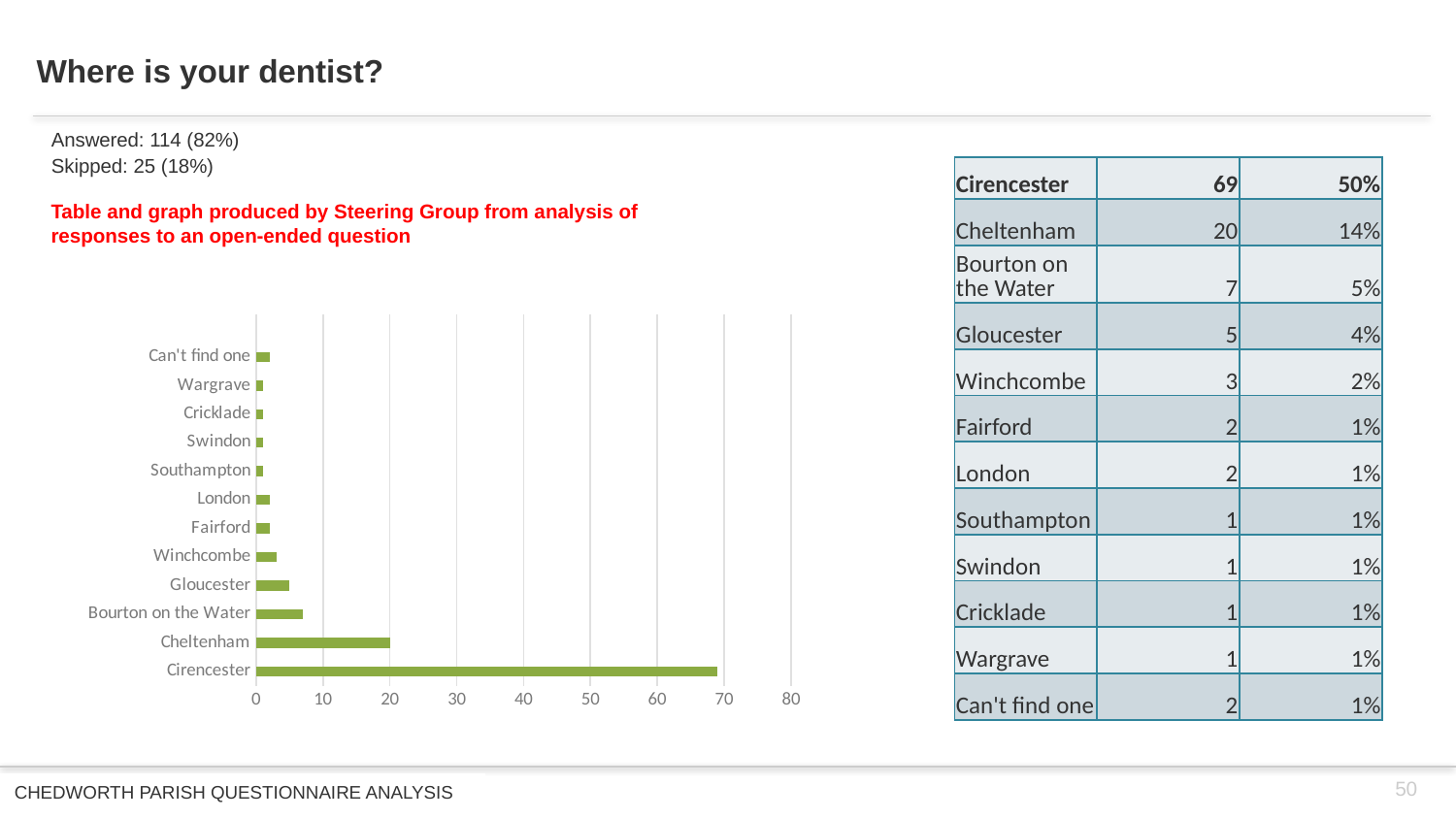
Is the value for Bourton on the Water greater or less than 10? less According to the table, what percentage of respondents have their dentist in Cheltenham? 14% Which category has the longest bar in the chart? Cirencester Is the value for Cirencester greater or less than 60? greater Is the value for Cheltenham greater or less than 30? less According to the table, how many respondents have their dentist in Cirencester? 69 What kind of chart is shown on the slide? bar chart What is the highest value shown on the horizontal axis of the chart? 80 Which has the larger value, Cheltenham or Bourton on the Water? Cheltenham Using the table values, what is the difference between the counts for Cirencester and Cheltenham? 49 How many categories (dentist locations) are plotted in the bar chart? 12 Which has the larger value, Gloucester or Winchcombe? Gloucester